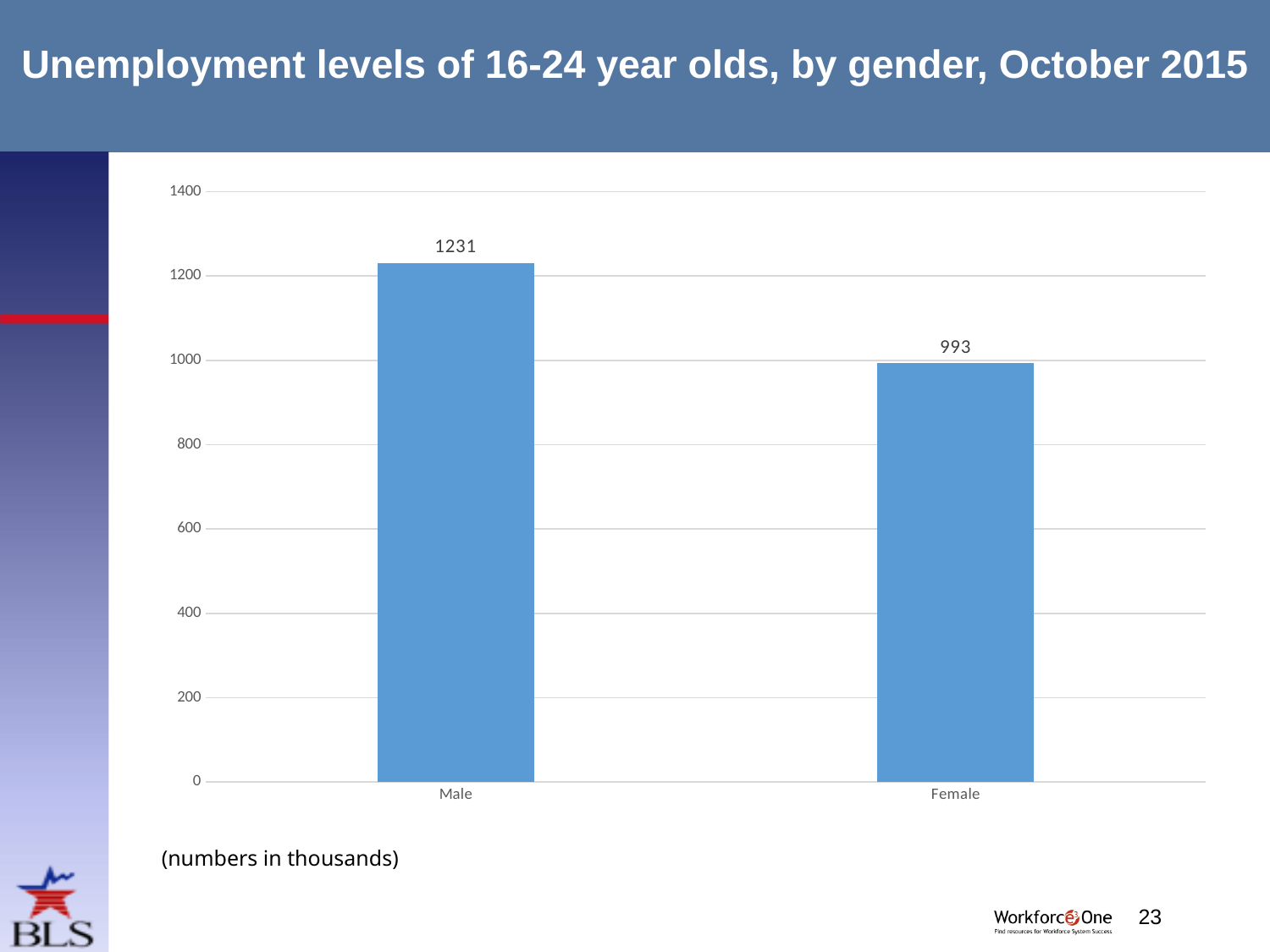
What kind of chart is shown on the slide? bar chart What is the highest value shown on the vertical axis? 1400 What is the unemployment level for Male 16-24 year olds? 1231 What is the difference between the Male and Female unemployment levels? 238 How many categories are shown on the x axis? 2 Which gender has the higher unemployment level? Male What is the unemployment level for Female 16-24 year olds? 993 What is the title of the slide? Unemployment levels of 16-24 year olds, by gender, October 2015 Is the value for Female greater or less than 1000? less Which gender has the lower unemployment level? Female In what units are the numbers on the chart expressed, according to the note below it? thousands Is the value for Male greater or less than 1200? greater